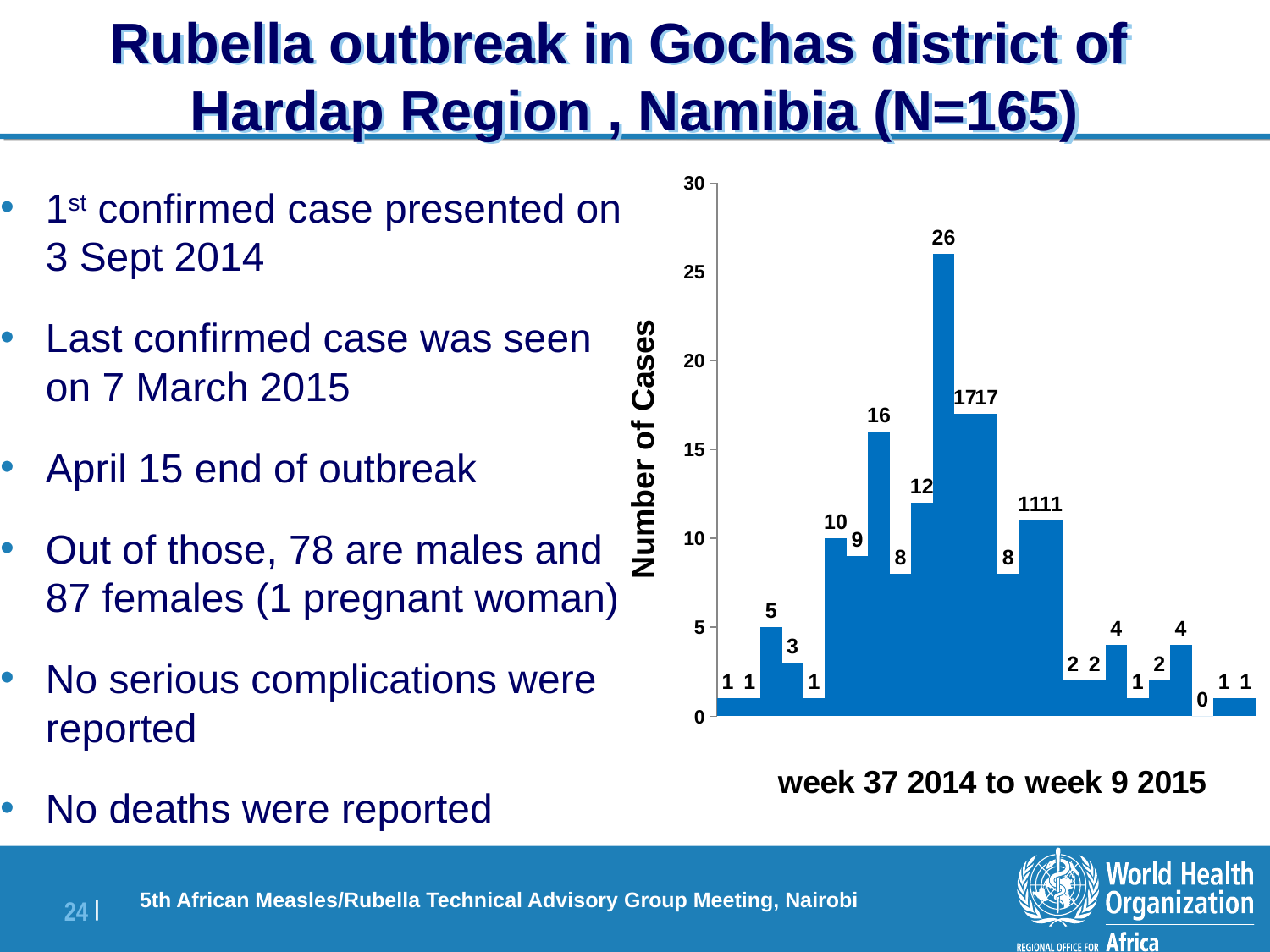
What is the value of the first bar on the left of the chart? 1 What period does the caption below the chart say the data covers? week 37 2014 to week 9 2015 How many bars have a value of 17? 2 What is the lowest value labelled on the chart? 0 What is the difference between the tallest bar (26) and the bar immediately to its right (17)? 9 Is the tallest bar greater or less than 25? greater What is the title of the vertical axis? Number of Cases How many bars are plotted on the chart? 25 What is the value of the last bar on the right of the chart? 1 How many bars have a value greater than 15? 4 What is the highest value shown on the chart? 26 What type of chart is shown on the slide? bar chart